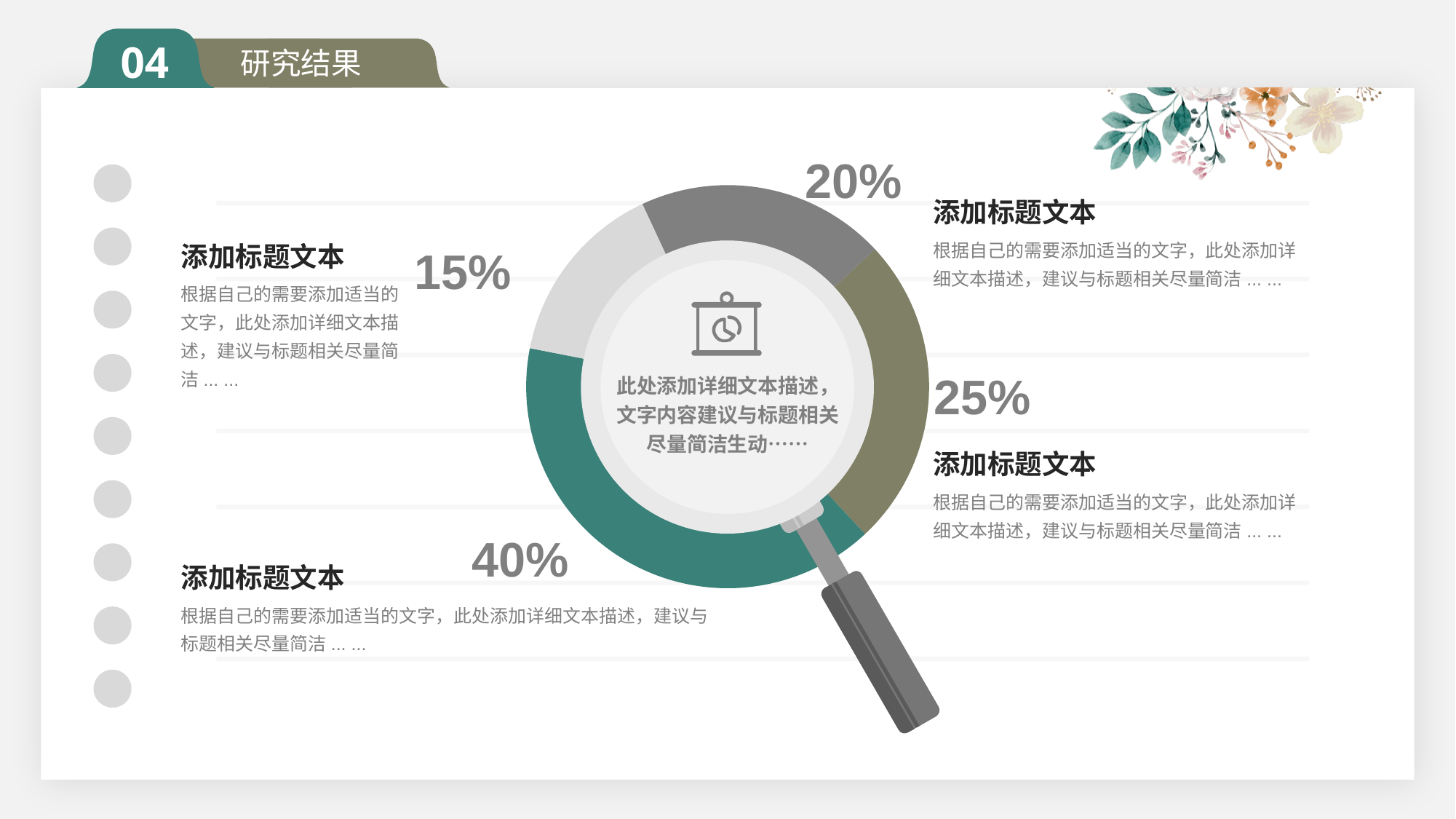
What percentage is labelled on the dark gray segment at the top of the donut chart? 20% What is the difference between the largest and smallest percentages on the donut chart? 25% What kind of chart is shown on the slide? Donut chart What percentage is labelled on the olive-green segment on the right of the donut chart? 25% What is the smallest percentage shown on the donut chart? 15% How many segments does the donut chart have? 4 What do the four percentages on the donut chart add up to? 100% Which is larger on the donut chart, the olive-green segment or the dark gray segment? The olive-green segment (25%) What percentage is labelled on the light gray segment on the left of the donut chart? 15% What is the largest percentage shown on the donut chart? 40% What is the section title shown in the header of the slide? 研究结果 What percentage is labelled on the teal segment of the donut chart? 40%